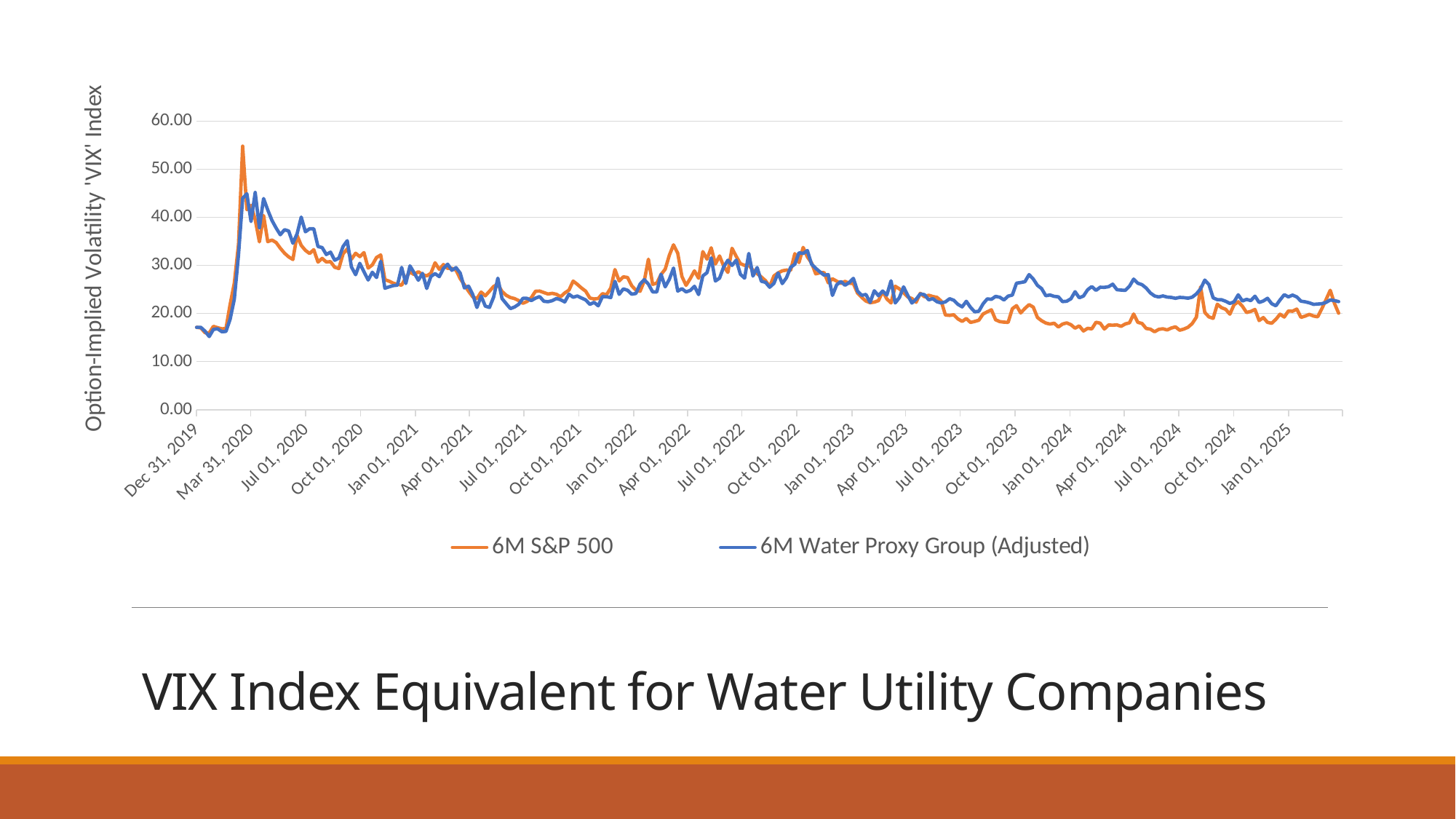
What is the label on the vertical axis? Option-Implied Volatility 'VIX' Index Around Jan 01, 2024, which series has the higher value, 6M S&P 500 or 6M Water Proxy Group (Adjusted)? 6M Water Proxy Group (Adjusted) Which series reaches the highest peak on the chart? 6M S&P 500 Is the peak value of the 6M S&P 500 series around Mar 31, 2020 greater or less than 50.00? greater How many series does the legend list? 2 Is the value of the 6M Water Proxy Group (Adjusted) series around Apr 01, 2024 greater or less than 20.00? greater What kind of chart is shown on the slide? line chart Is the value of the 6M S&P 500 series around Jul 01, 2024 greater or less than 20.00? less Between Mar 31, 2020 and Jul 01, 2021, do the values of the 6M S&P 500 series generally rise or fall? fall What are the two series named in the legend? 6M S&P 500 and 6M Water Proxy Group (Adjusted)